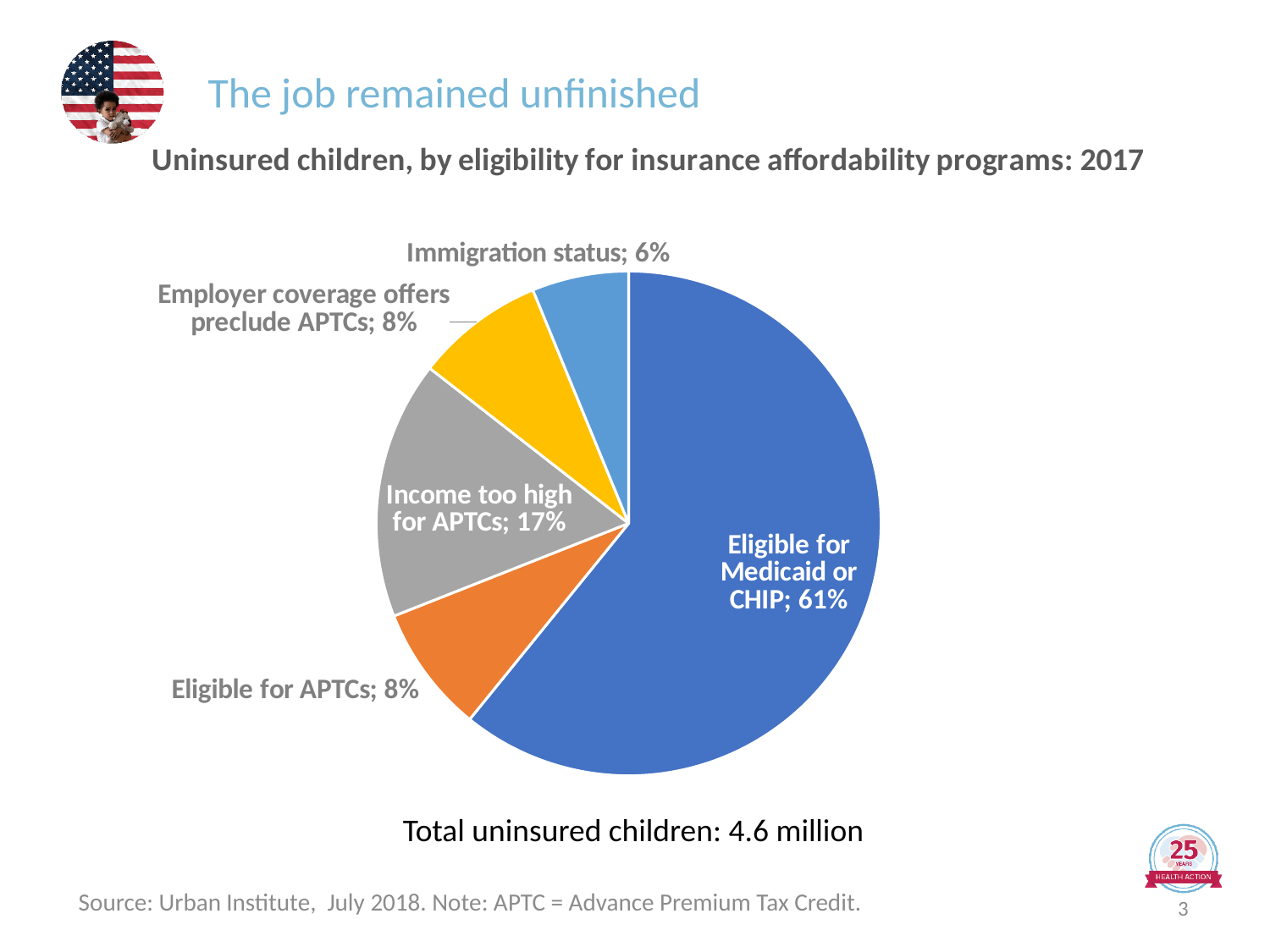
How many categories does the pie chart show? 5 What share of uninsured children are eligible for Medicaid or CHIP? 61% Which category has the largest share of uninsured children? Eligible for Medicaid or CHIP Which is larger: the share for Income too high for APTCs or the share for Employer coverage offers preclude APTCs? Income too high for APTCs What is the difference in percentage points between the Eligible for Medicaid or CHIP slice and the Income too high for APTCs slice? 44 What share of uninsured children are eligible for APTCs? 8% What is the total number of uninsured children stated below the chart? 4.6 million What share of uninsured children are uninsured due to immigration status? 6% What share of uninsured children have income too high for APTCs? 17% Which category has the smallest share of uninsured children? Immigration status What is the title of the chart? Uninsured children, by eligibility for insurance affordability programs: 2017 What kind of chart is shown on the slide? Pie chart